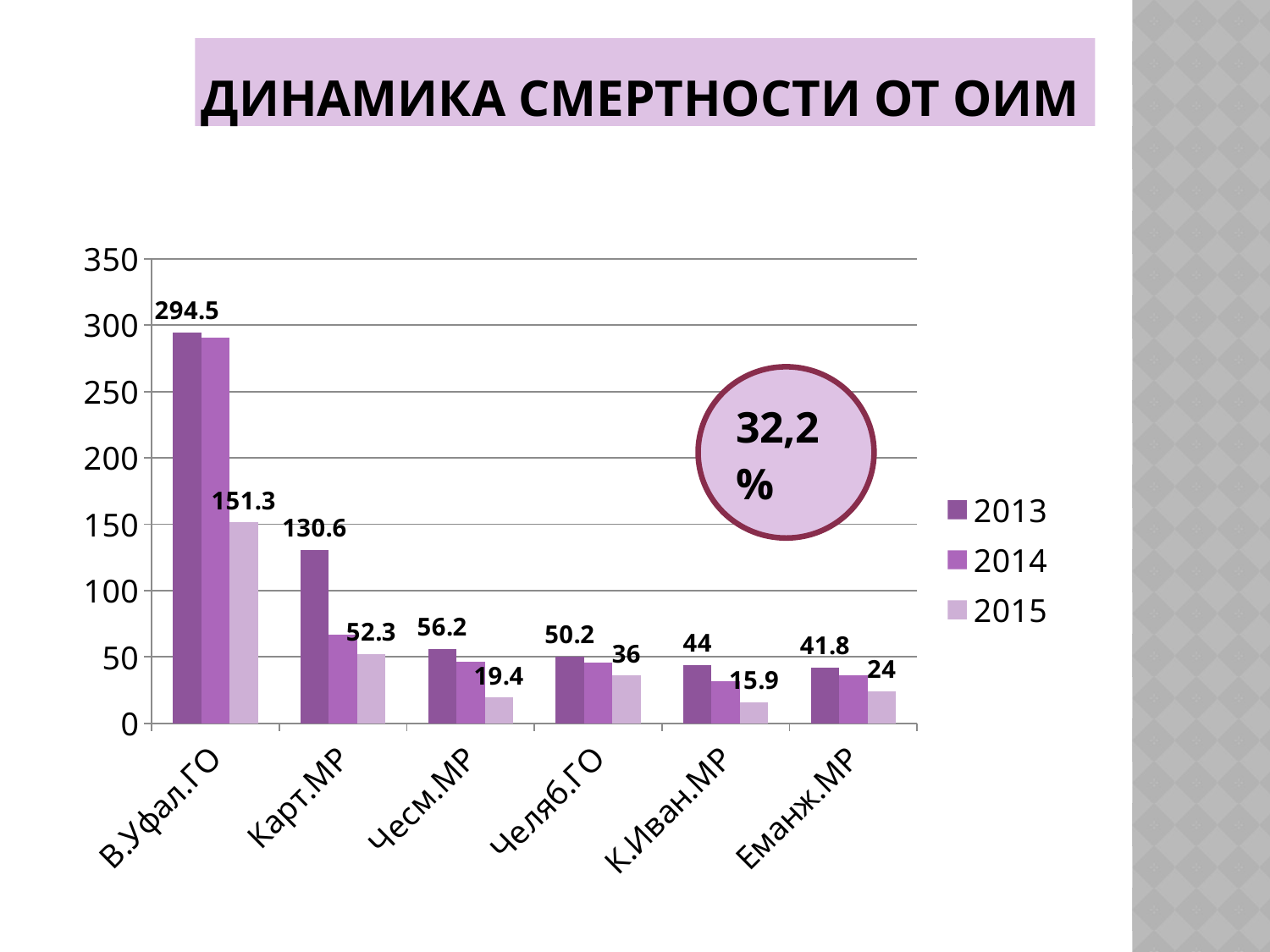
What is the difference between the 2013 and 2015 values for Чесм.МР? 36.8 Which category has the lowest 2015 value? К.Иван.МР How many categories are shown on the x axis? 6 What is the 2013 value for В.Уфал.ГО? 294.5 Which category has the highest 2013 value? В.Уфал.ГО What is the 2015 value for К.Иван.МР? 15.9 What kind of chart is shown on the slide? bar chart Is the 2014 value for Карт.МР greater or less than 100? less What is the title of the slide? ДИНАМИКА СМЕРТНОСТИ ОТ ОИМ How many series does the legend list? 3 What is the 2015 value for Карт.МР? 52.3 Which is larger, the 2015 value for Челяб.ГО or the 2015 value for Еманж.МР? Челяб.ГО